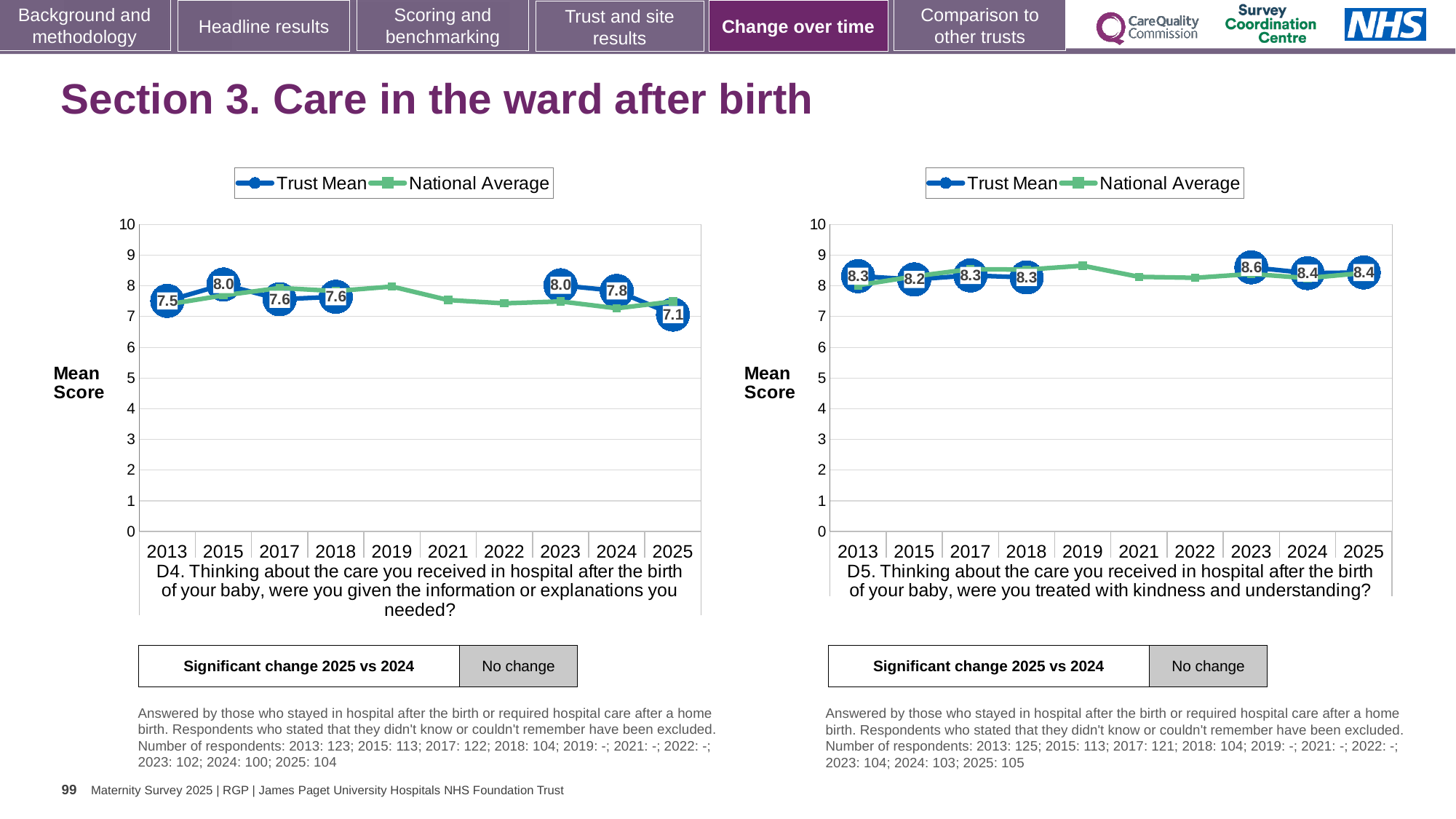
In the D4 chart (left), is the National Average for 2019 greater or less than 7? greater In the D4 chart (left), what is the difference between the Trust Mean for 2024 and the Trust Mean for 2025? 0.7 In the D4 chart (left), which year has the lowest labelled Trust Mean? 2025 How many years are shown on the x axis of the D5 chart (right)? 10 In the D4 chart (left), what is the Trust Mean for 2013? 7.5 In the D5 chart (right), what is the Trust Mean for 2015? 8.2 How many series does the legend of the D4 chart (left) list? 2 In the D5 chart (right), what is the Trust Mean for 2023? 8.6 In the D4 chart (left), what is the Trust Mean for 2025? 7.1 What type of chart is the D5 chart (right)? Line chart In the D5 chart (right), which year has the highest labelled Trust Mean? 2023 In the D5 chart (right), which is larger: the Trust Mean for 2023 or the Trust Mean for 2025? 2023